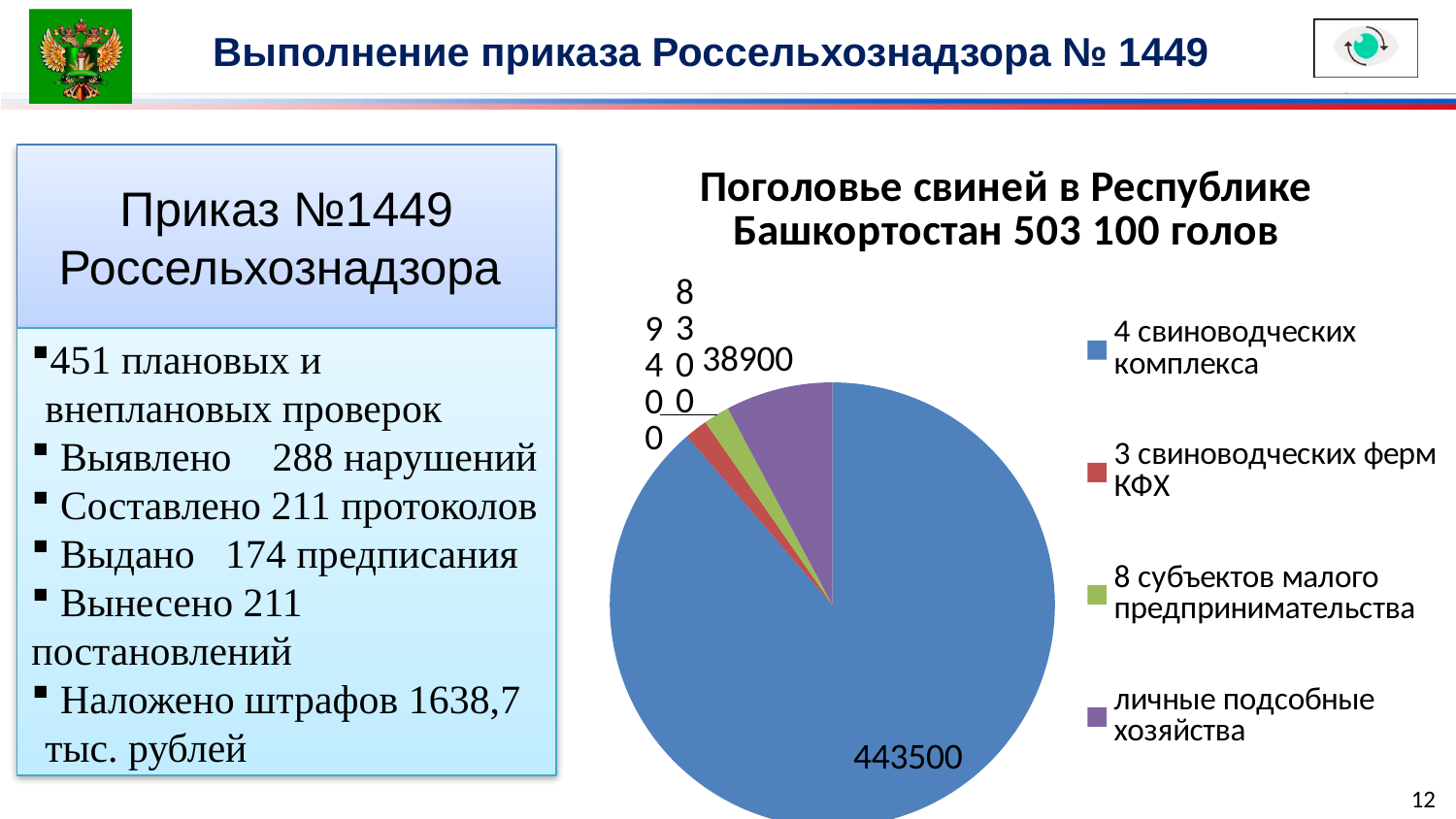
What is the title of the pie chart? Поголовье свиней в Республике Башкортостан 503 100 голов Which category has the largest slice in the pie chart? 4 свиноводческих комплекса How many entries does the legend of the pie chart list? 4 What total number of pigs is stated in the pie chart title? 503 100 Which is larger in the pie chart: '4 свиноводческих комплекса' or 'личные подсобные хозяйства'? 4 свиноводческих комплекса What kind of chart is shown on the slide? pie chart What is the difference between the values for '4 свиноводческих комплекса' and 'личные подсобные хозяйства'? 404600 What colour is the slice for 'личные подсобные хозяйства' in the pie chart? purple What value is shown for 'личные подсобные хозяйства' in the pie chart? 38900 How many slices does the pie chart have? 4 What value is shown for '4 свиноводческих комплекса' in the pie chart? 443500